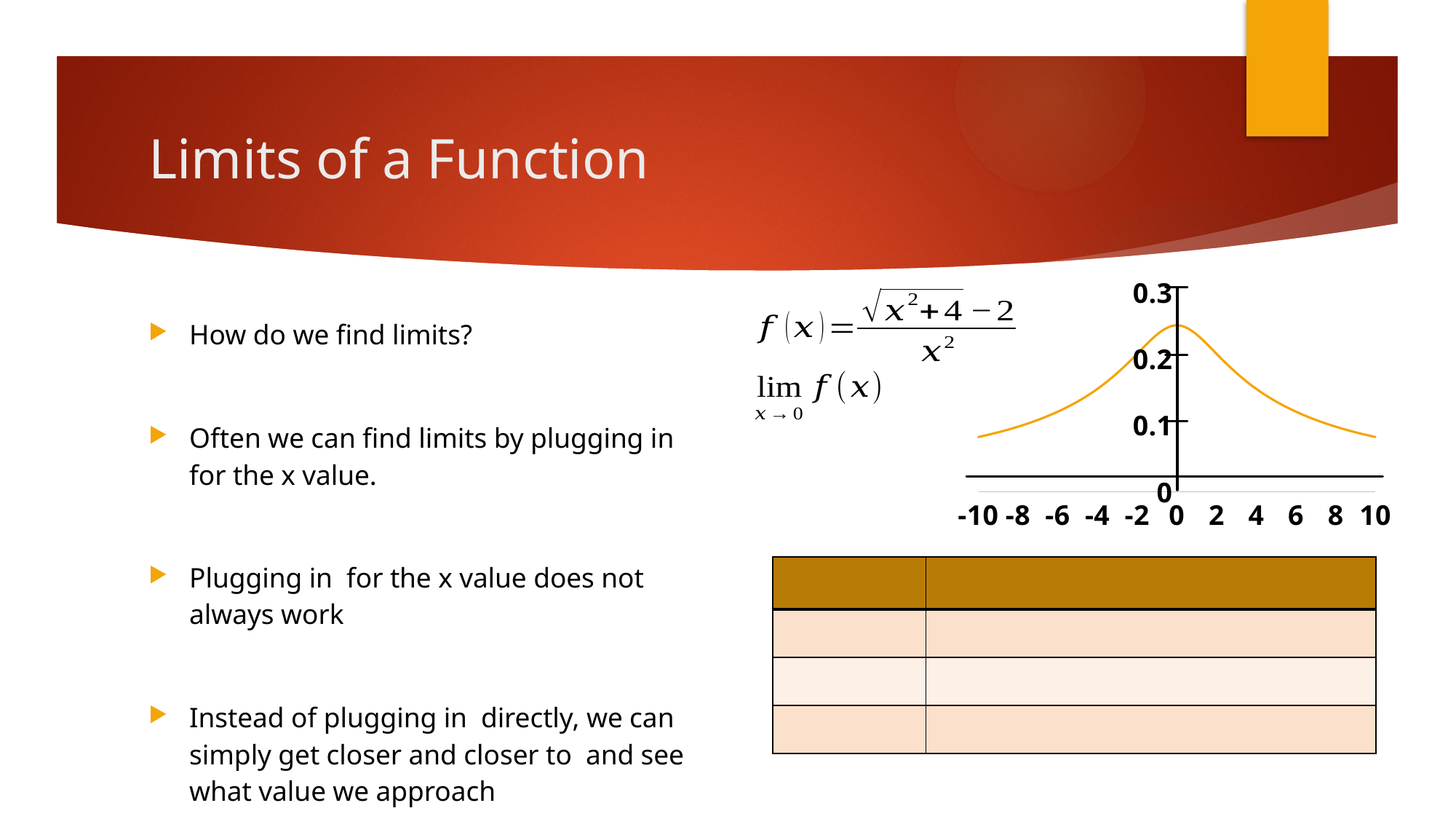
What kind of chart is shown on the slide? line chart Does the curve rise or fall as x increases from 0 to 10? fall Which is larger, the value of the curve at x = 2 or at x = 8? x = 2 Is the value of the curve at x = 10 greater or less than 0.1? less Is the value of the curve at x = 0 greater or less than 0.2? greater Is the value of the curve at x = 4 greater or less than 0.1? greater Does the curve rise or fall as x increases from -10 to 0? rise How many tick labels are shown on the x axis? 11 At which x value does the plotted curve reach its highest point? 0 What colour is the plotted curve? orange